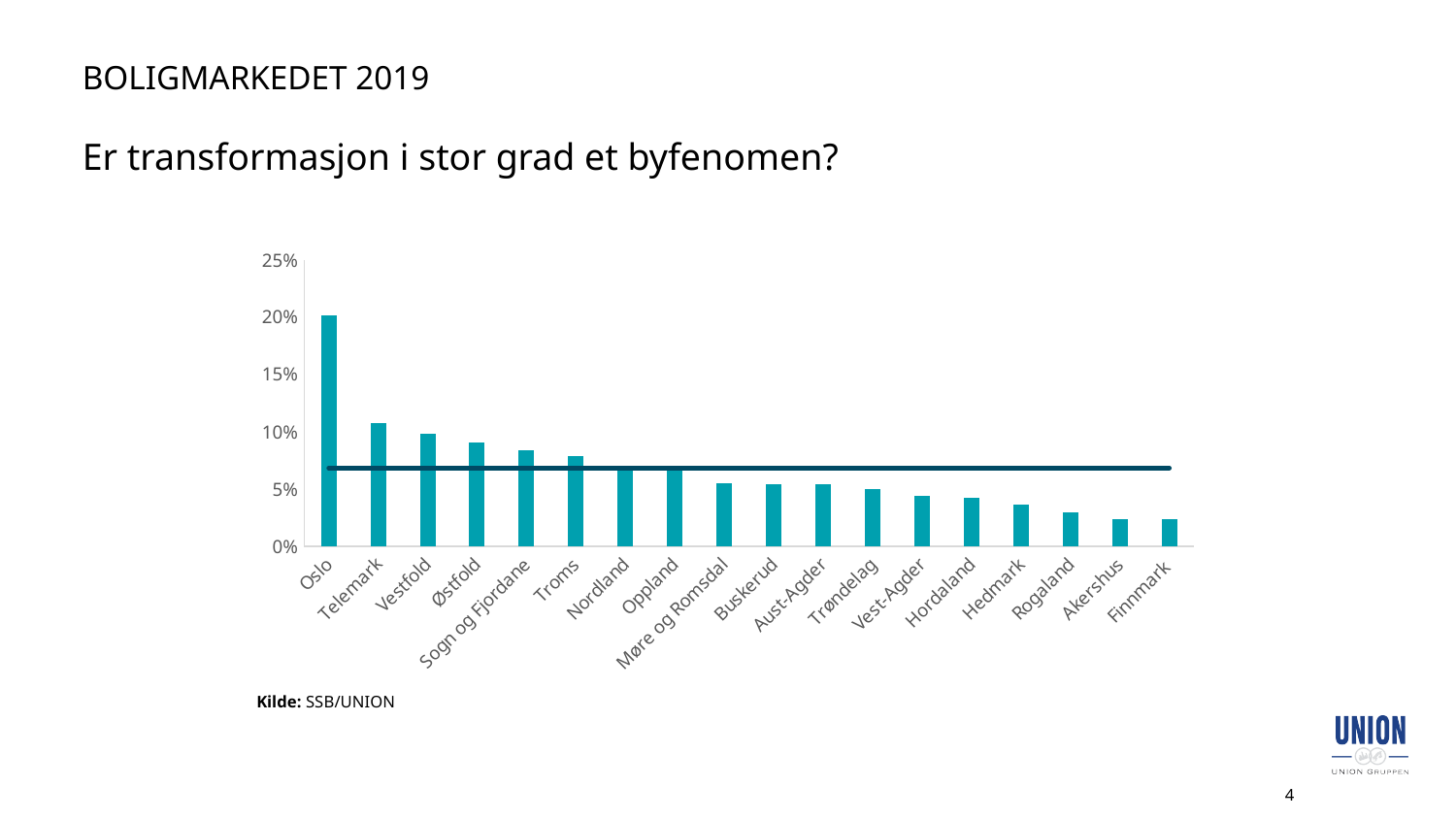
What source is cited below the chart? SSB/UNION What kind of chart is shown on the slide? bar chart Is the value for Finnmark greater or less than 5%? less Which county has the highest value in the chart? Oslo Do the bar values rise or fall moving from left to right along the x axis? fall How many counties (categories) are shown on the x axis of the chart? 18 Is the value for Nordland greater or less than 5%? greater Is the value for Østfold greater or less than 10%? less Which has the larger value, Telemark or Oslo? Oslo Which has the larger value, Troms or Rogaland? Troms